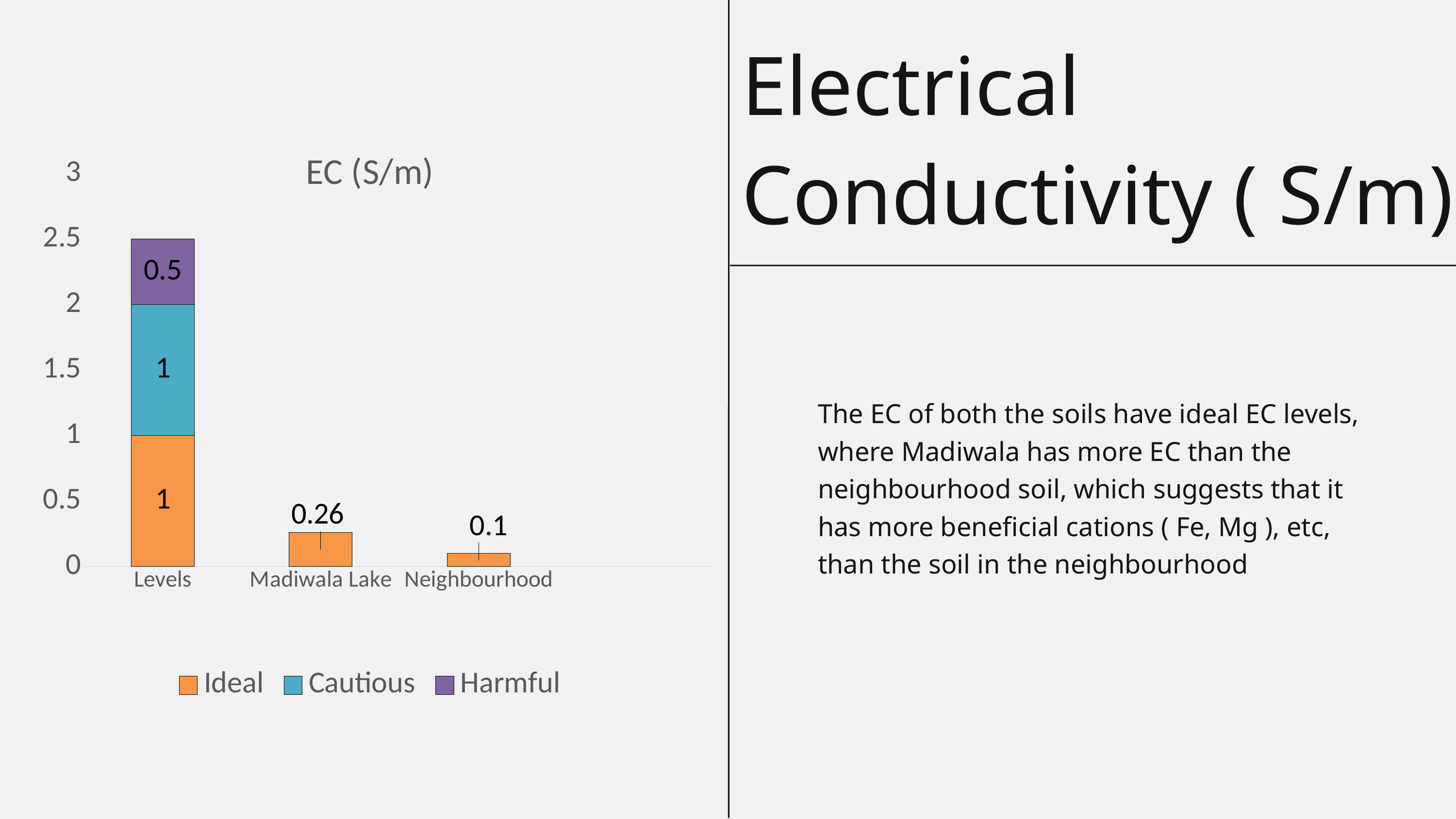
How many series does the legend list? 3 What is the total of the stacked bar for Levels? 2.5 What is the difference between the Madiwala Lake value and the Neighbourhood value? 0.16 How many categories are shown on the x axis? 3 What kind of chart is shown on the slide? bar chart Which is larger, the value for Madiwala Lake or the value for Neighbourhood? Madiwala Lake What is the Ideal value for Neighbourhood? 0.1 What is the title of the chart? EC (S/m) What is the Ideal value for Madiwala Lake? 0.26 Which category has the lowest bar? Neighbourhood What is the Cautious value for Levels? 1 What is the Harmful value for Levels? 0.5